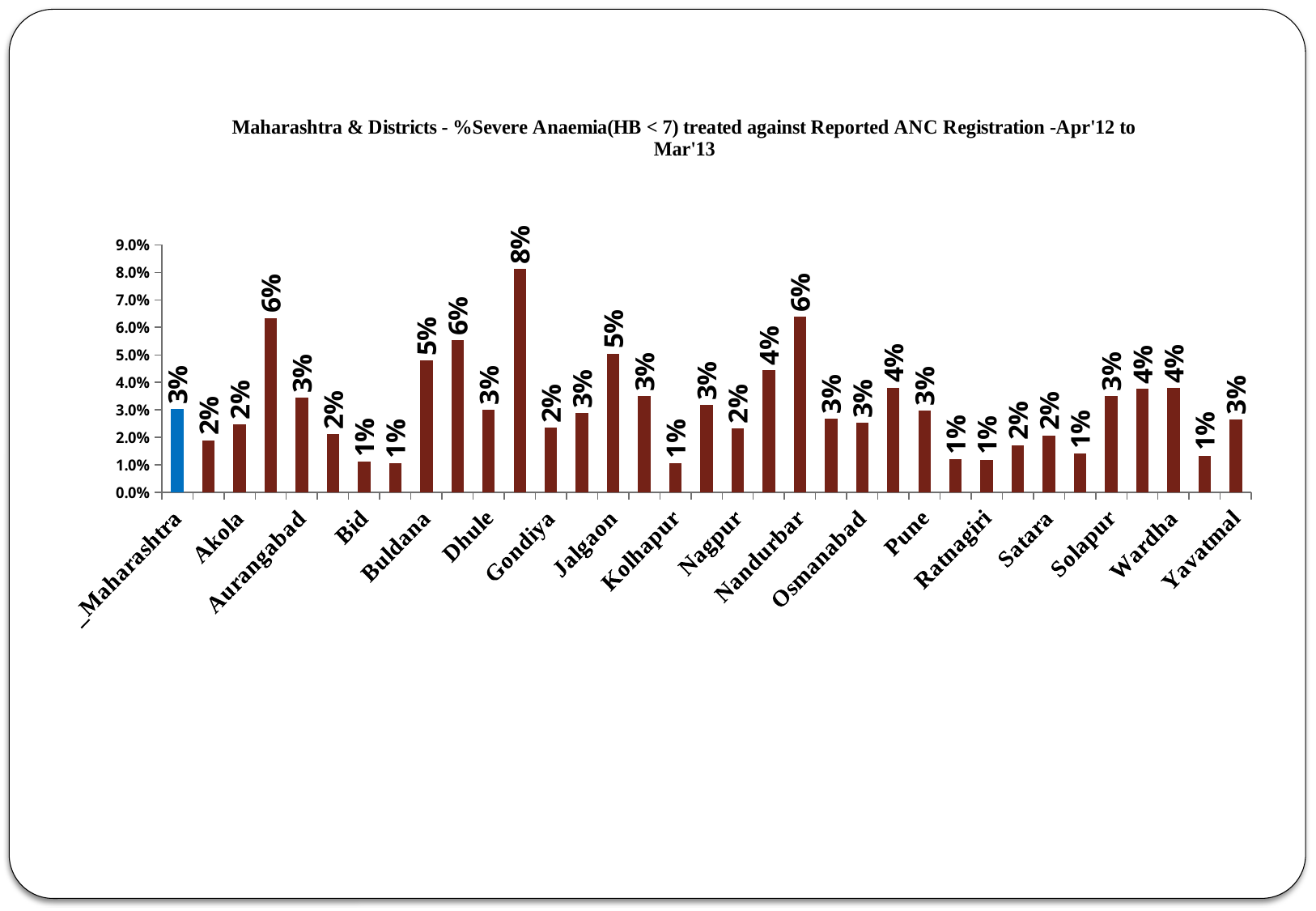
What is the highest value shown on the chart? 8% What kind of chart is shown on the slide? Bar chart Is the value for Buldana greater or less than 4.0%? greater What is the value for _Maharashtra? 3% What is the difference between the values for Nandurbar and _Maharashtra? 3% Which is larger, the value for Nandurbar or the value for Kolhapur? Nandurbar What is the highest value shown on the vertical axis? 9.0% What colour is the bar for _Maharashtra? Blue What is the value for Wardha? 4% What is the lowest value shown on the chart? 1% What is the value for Bid? 1% What is the value for Nandurbar? 6%